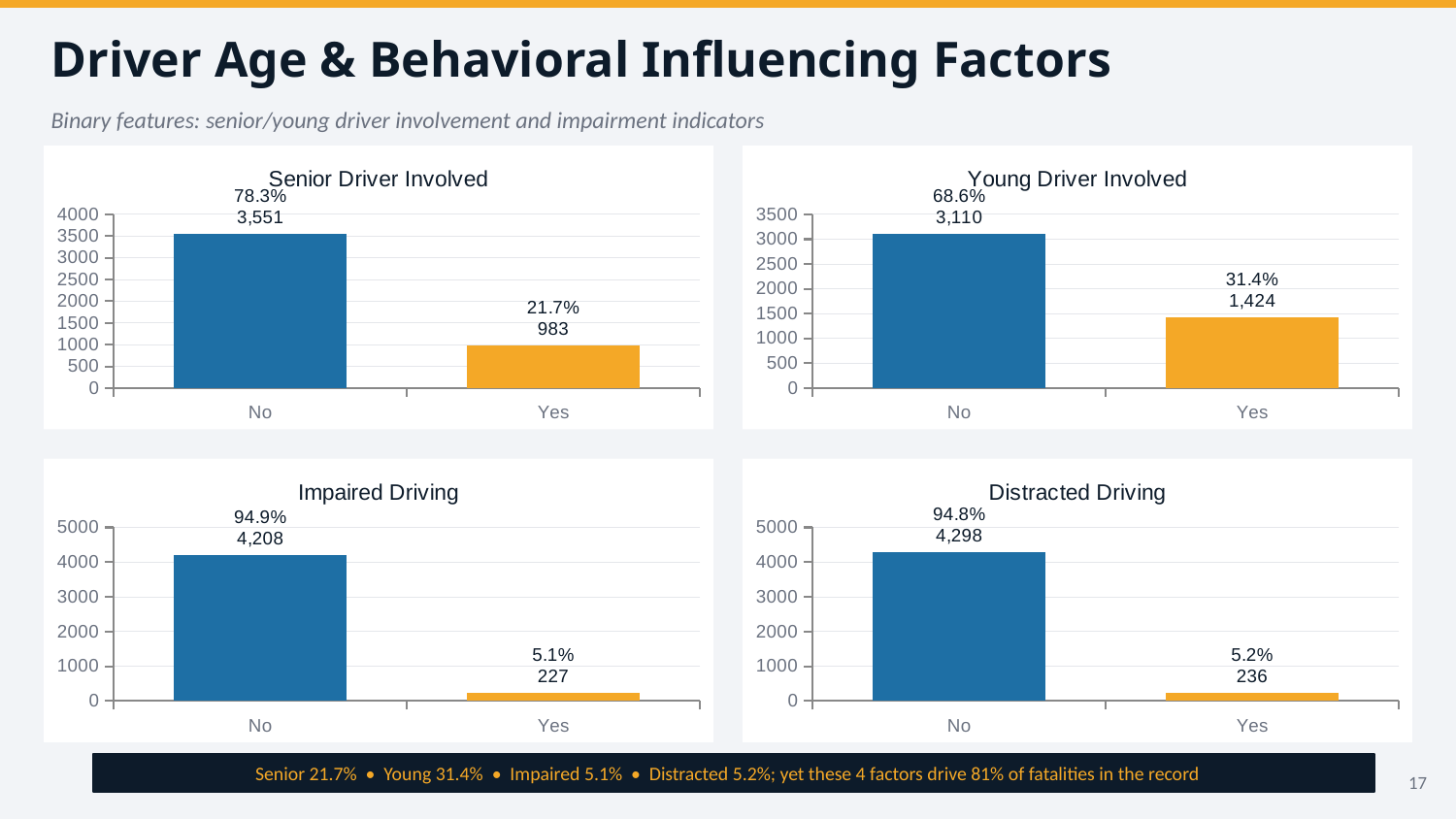
In the Distracted Driving chart, what is the total of the No and Yes values? 4,534 In the Young Driver Involved chart, what is the value for Yes? 1,424 What kind of chart is the Young Driver Involved chart? Bar chart In the Impaired Driving chart, which category has the highest value? No In the Senior Driver Involved chart, is the value for Yes greater or less than 1000? less How many categories are shown on the x axis of the Impaired Driving chart? 2 In the Young Driver Involved chart, what is the difference between the No and Yes values? 1,686 In the Impaired Driving chart, what is the value for Yes? 227 In the Distracted Driving chart, what is the value for No? 4,298 In the Senior Driver Involved chart, what is the value for No? 3,551 In the Distracted Driving chart, what percentage is shown for Yes? 5.2% In the Senior Driver Involved chart, what percentage is shown for Yes? 21.7%